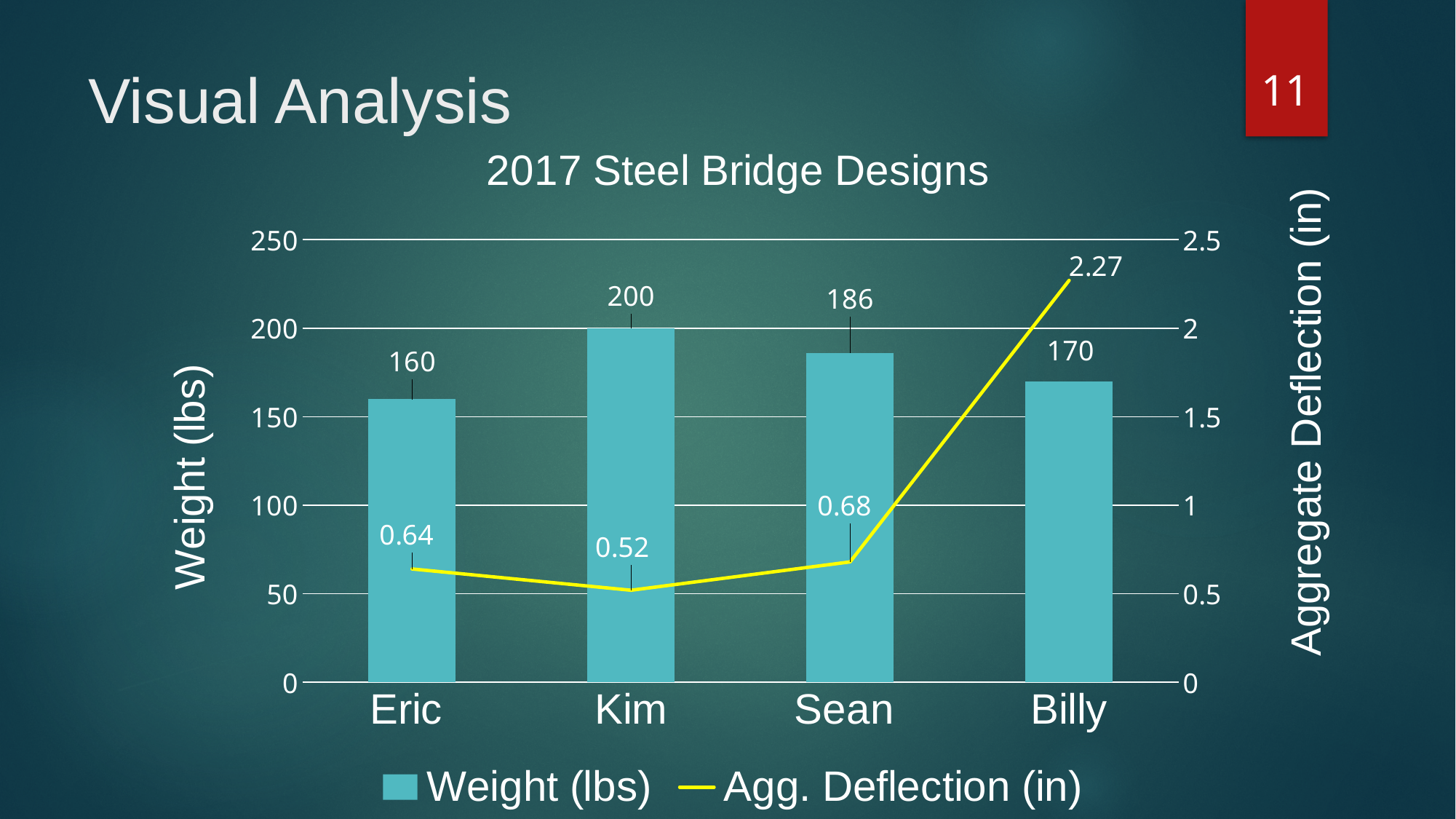
What is the difference in Weight (lbs) between Kim and Eric? 40 What is the title of the chart? 2017 Steel Bridge Designs Which design has the lowest Agg. Deflection (in)? Kim What kind of chart is used for the Weight (lbs) series? Bar chart What is the Agg. Deflection (in) for Billy? 2.27 What is the Weight (lbs) for Sean? 186 How many series does the legend list? 2 How many designs are shown on the x axis? 4 What is the label of the right-hand vertical axis? Aggregate Deflection (in) Which design has the highest Weight (lbs)? Kim Which has a larger Agg. Deflection (in), Eric or Sean? Sean What is the Weight (lbs) for Kim? 200